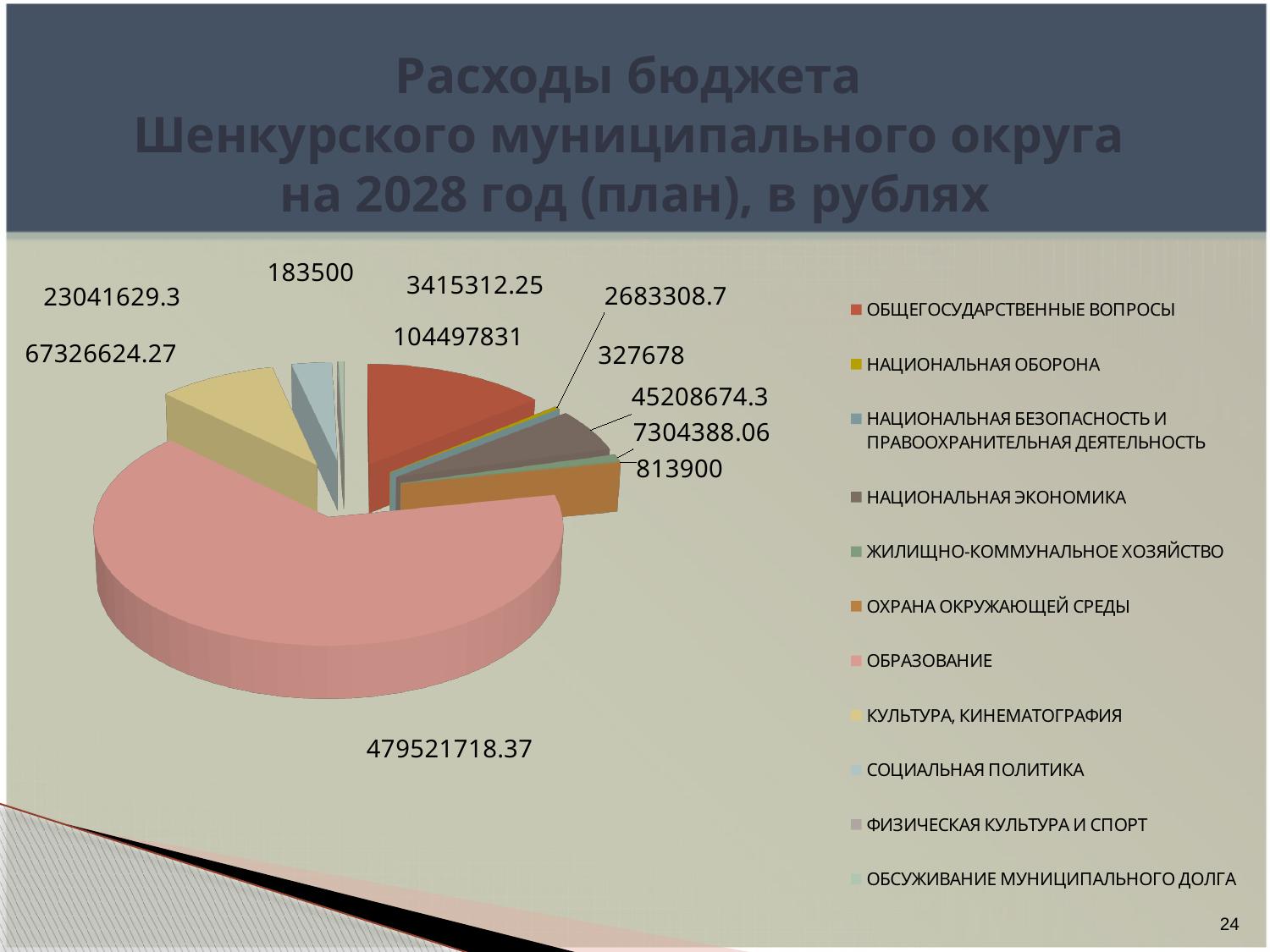
Which is larger in the pie chart: КУЛЬТУРА, КИНЕМАТОГРАФИЯ or НАЦИОНАЛЬНАЯ ЭКОНОМИКА? КУЛЬТУРА, КИНЕМАТОГРАФИЯ What is the value for ОБЩЕГОСУДАРСТВЕННЫЕ ВОПРОСЫ in the pie chart? 104497831 What kind of chart is shown on the slide? pie chart Which category has the largest slice in the pie chart? ОБРАЗОВАНИЕ What is the value for КУЛЬТУРА, КИНЕМАТОГРАФИЯ in the pie chart? 67326624.27 What is the title of the chart on the slide? Расходы бюджета Шенкурского муниципального округа на 2028 год (план), в рублях What is the value for СОЦИАЛЬНАЯ ПОЛИТИКА in the pie chart? 23041629.3 What is the value for ОБРАЗОВАНИЕ in the pie chart? 479521718.37 How many categories does the legend of the pie chart list? 11 What is the difference between the values for ОБРАЗОВАНИЕ and ОБЩЕГОСУДАРСТВЕННЫЕ ВОПРОСЫ in the pie chart? 375023887.37 What is the value for НАЦИОНАЛЬНАЯ ЭКОНОМИКА in the pie chart? 45208674.3 Which category has the smallest value in the pie chart? ФИЗИЧЕСКАЯ КУЛЬТУРА И СПОРТ